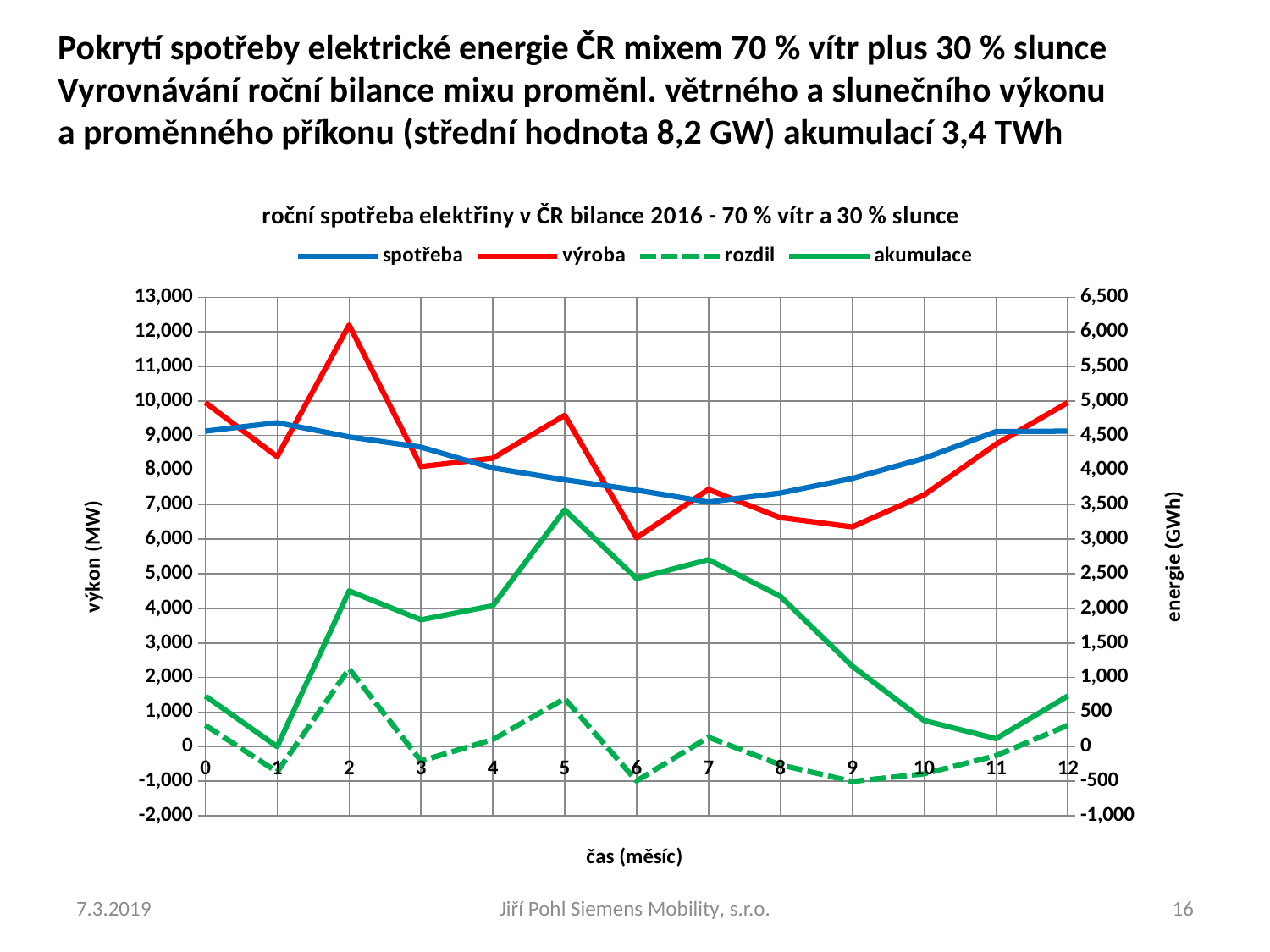
At month 6, which is larger: spotřeba or výroba? spotřeba Does the spotřeba series rise or fall from month 1 to month 7? fall What kind of chart is shown on the slide? line chart In which month does the akumulace series reach its highest value? 5 Is the value of spotřeba at month 1 greater or less than 9,000 MW? greater What is the label of the right-hand vertical axis? energie (GWh) In which month does the výroba series reach its highest value? 2 Is the value of výroba at month 2 greater or less than 11,000 MW? greater In which month does the výroba series reach its lowest value? 6 How many series does the chart legend list? 4 Is the value of výroba at month 6 greater or less than 7,000 MW? less How many month points are plotted along the x axis (from 0 to 12)? 13